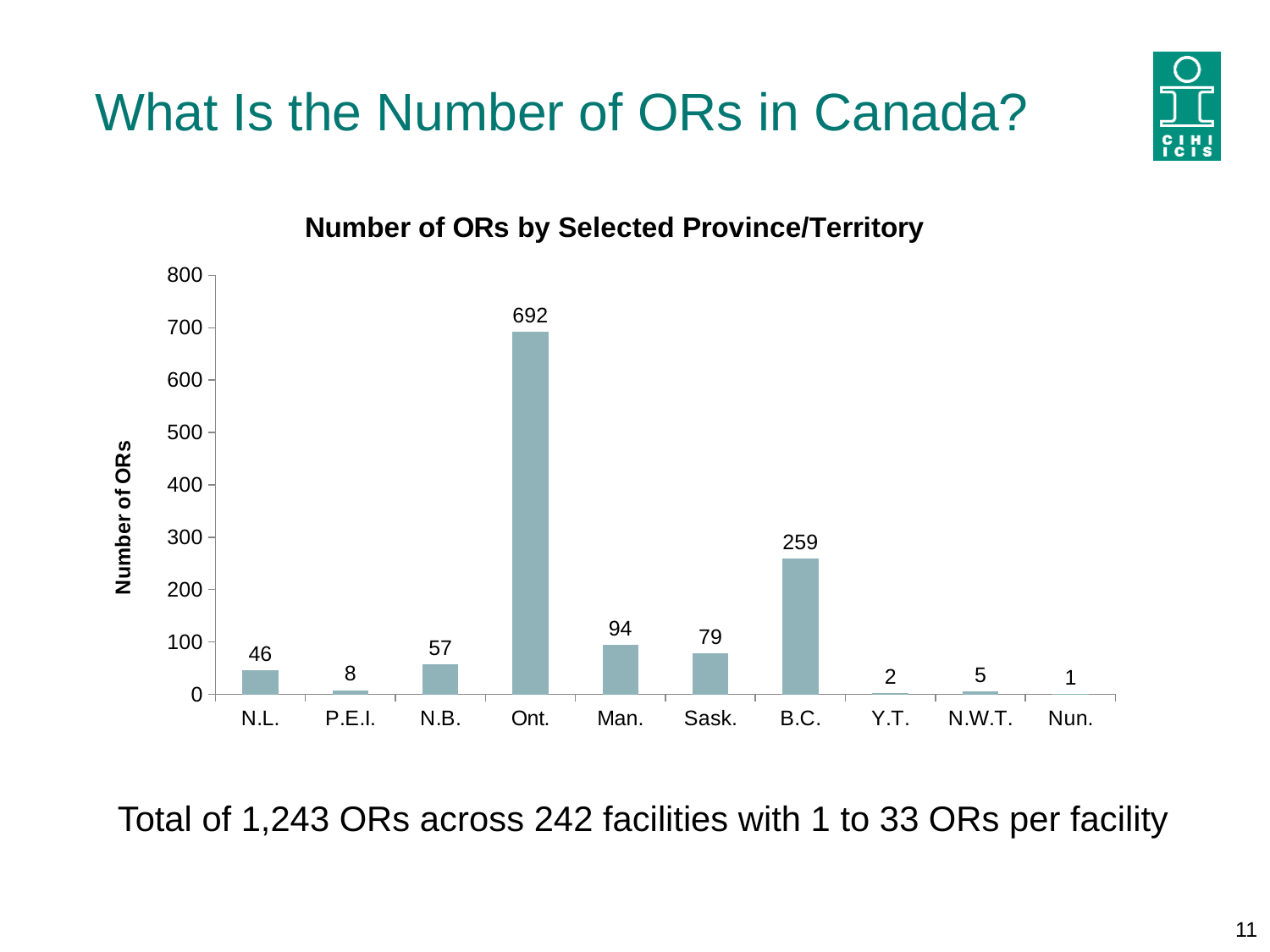
Which province/territory has the highest number of ORs? Ont. What kind of chart is shown on the slide? Bar chart What is the title of the chart? Number of ORs by Selected Province/Territory What is the number of ORs for Sask.? 79 Which province/territory has the lowest number of ORs? Nun. What is the number of ORs for N.W.T.? 5 What is the difference in the number of ORs between Ont. and B.C.? 433 What is the difference in the number of ORs between Man. and Sask.? 15 What is the number of ORs for B.C.? 259 What is the number of ORs for Ont.? 692 How many provinces/territories are shown on the x axis? 10 Which has more ORs, N.B. or N.L.? N.B.